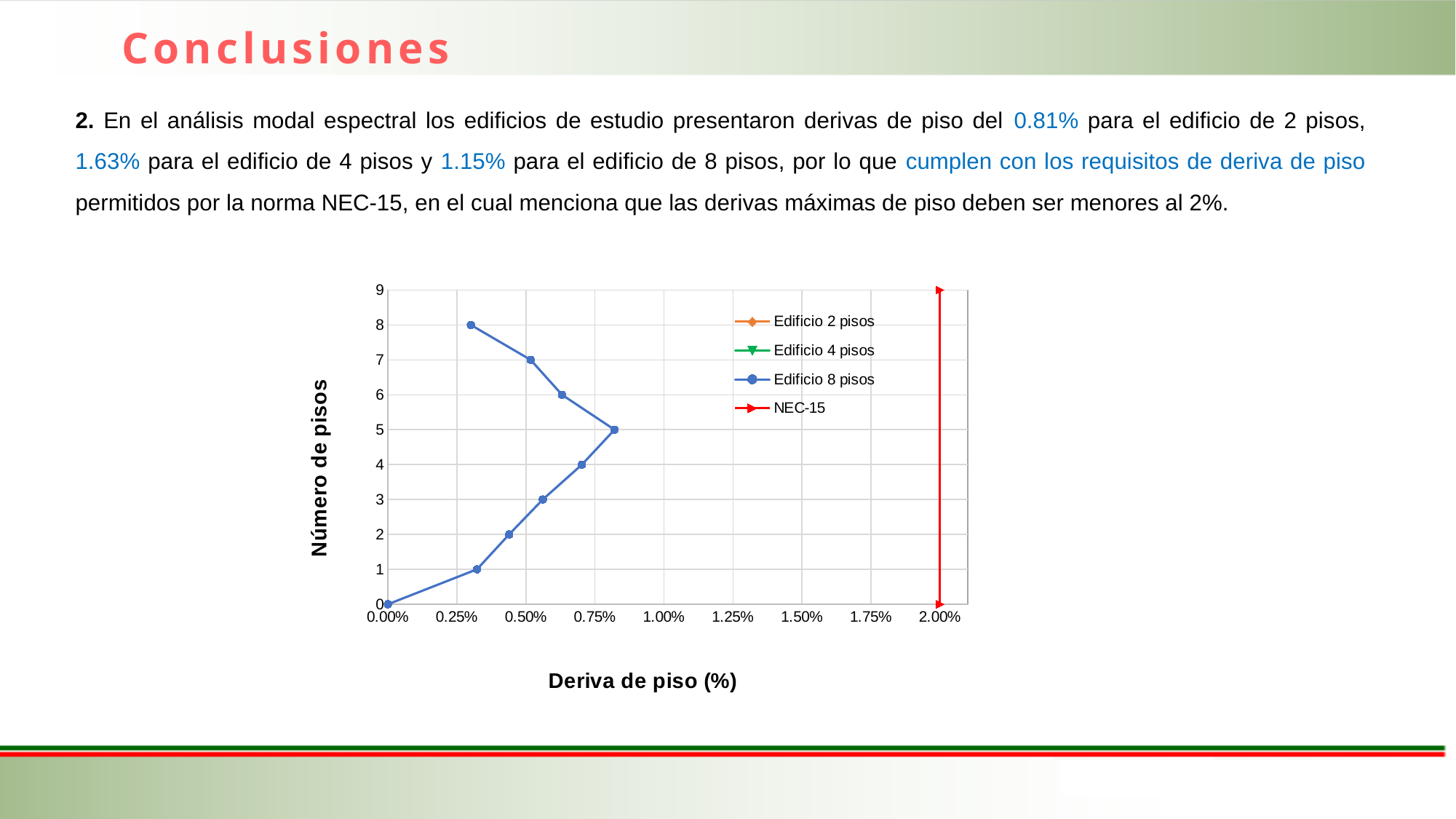
What is the title of the x axis? Deriva de piso (%) Is the drift for the Edificio 8 pisos series at floor 4 greater or less than 0.50%? greater For the Edificio 8 pisos series, which floor has the highest drift? 5 Is the drift for the Edificio 8 pisos series at floor 5 greater or less than 0.75%? greater What is the drift value for the Edificio 8 pisos series at floor 0? 0.00% Is the drift for the Edificio 8 pisos series at floor 8 greater or less than 0.50%? less For the Edificio 8 pisos series, which has the larger drift: floor 5 or floor 8? floor 5 How many data points are plotted for the Edificio 8 pisos series? 9 At what drift value is the NEC-15 limit line drawn? 2.00% What is the title of the y axis? Número de pisos How many series does the legend list? 4 What kind of chart is shown on the slide? line chart